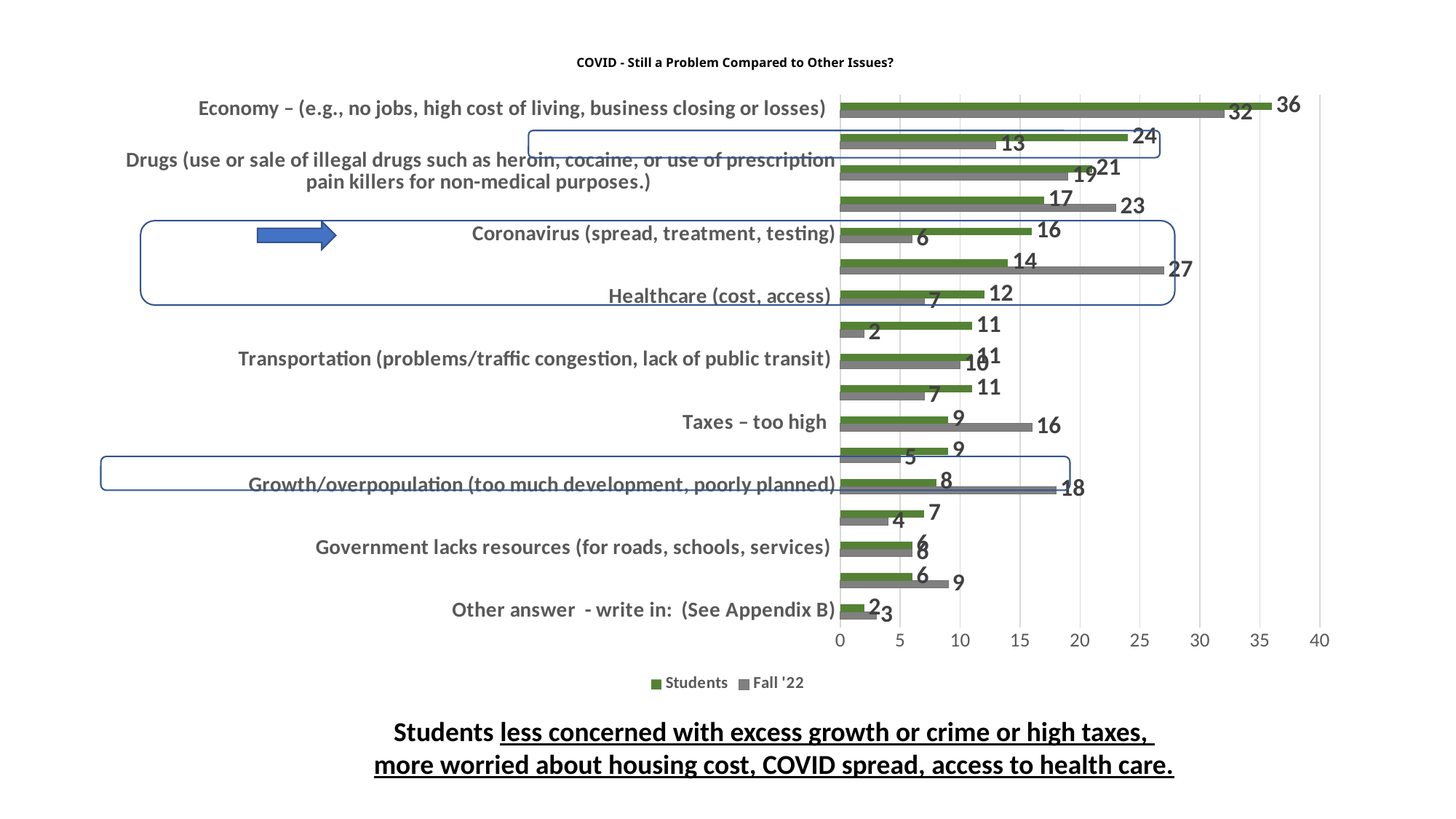
What is the difference between the Fall '22 and Students values for Taxes – too high? 7 What kind of chart is shown on the slide? bar chart What is the Fall '22 value for Coronavirus (spread, treatment, testing)? 6 What is the Students value for Economy? 36 How many series does the legend list? 2 What is the difference between the Students and Fall '22 values for Coronavirus? 10 Which category has the highest Students value? Economy What is the Fall '22 value for Growth/overpopulation? 18 For Economy, which series has the larger value, Students or Fall '22? Students For Growth/overpopulation, which series has the larger value, Students or Fall '22? Fall '22 What is the Students value for Healthcare (cost, access)? 12 What is the title of the chart? COVID - Still a Problem Compared to Other Issues?